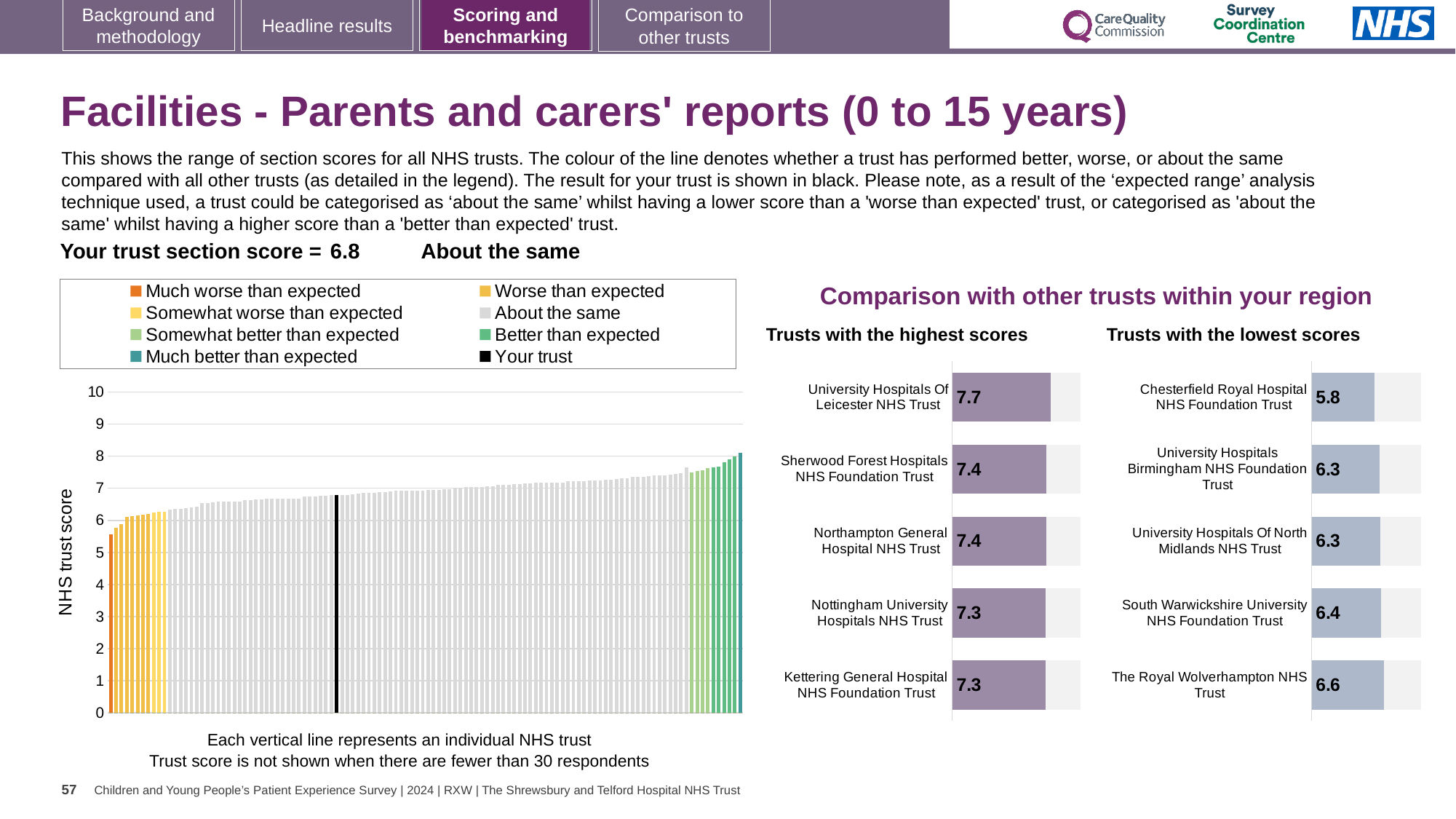
How many entries does the legend of the large chart on the left list? 8 In the large chart on the left showing all NHS trusts, is the value for your trust (the black bar) greater or less than 7? less In the 'Trusts with the lowest scores' chart, which trust has the lowest score? Chesterfield Royal Hospital NHS Foundation Trust In the 'Trusts with the highest scores' chart, what is the score for University Hospitals Of Leicester NHS Trust? 7.7 How many trusts are listed in the 'Trusts with the highest scores' chart? 5 In the large chart on the left showing all NHS trusts, do the bar values rise or fall from left to right? rise In the 'Trusts with the lowest scores' chart, which has the larger score: South Warwickshire University NHS Foundation Trust or University Hospitals Of North Midlands NHS Trust? South Warwickshire University NHS Foundation Trust In the 'Trusts with the highest scores' chart, which trust has the highest score? University Hospitals Of Leicester NHS Trust In the 'Trusts with the highest scores' chart, what is the difference between the scores of University Hospitals Of Leicester NHS Trust and Kettering General Hospital NHS Foundation Trust? 0.4 In the 'Trusts with the lowest scores' chart, what is the score for Chesterfield Royal Hospital NHS Foundation Trust? 5.8 In the large chart on the left showing all NHS trusts, what is the section score for your trust (the black bar)? 6.8 In the 'Trusts with the lowest scores' chart, what is the difference between the scores of The Royal Wolverhampton NHS Trust and Chesterfield Royal Hospital NHS Foundation Trust? 0.8